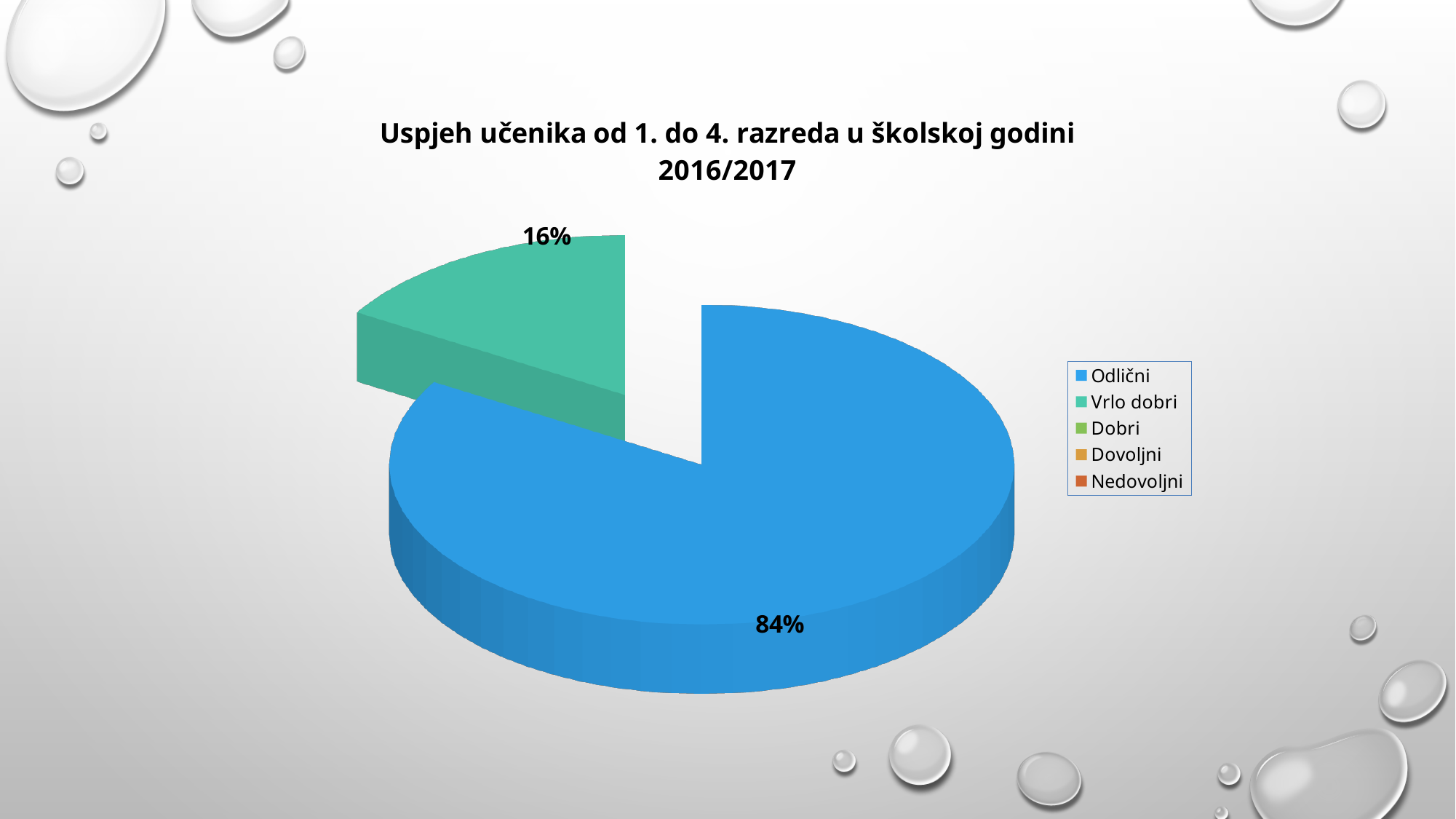
What share of the pie does Vrlo dobri represent? 16% What colour is the Odlični slice? Blue What share of the pie does Odlični represent? 84% How many categories does the legend list? 5 How many slices with data labels are visible in the pie? 2 What is the title of the chart? Uspjeh učenika od 1. do 4. razreda u školskoj godini 2016/2017 What is the difference in percentage points between the Odlični and Vrlo dobri slices? 68 Which is larger, the Odlični slice or the Vrlo dobri slice? Odlični Which category has the largest slice of the pie? Odlični What kind of chart is shown on the slide? Pie chart Which of the two visible slices is smaller, Odlični or Vrlo dobri? Vrlo dobri